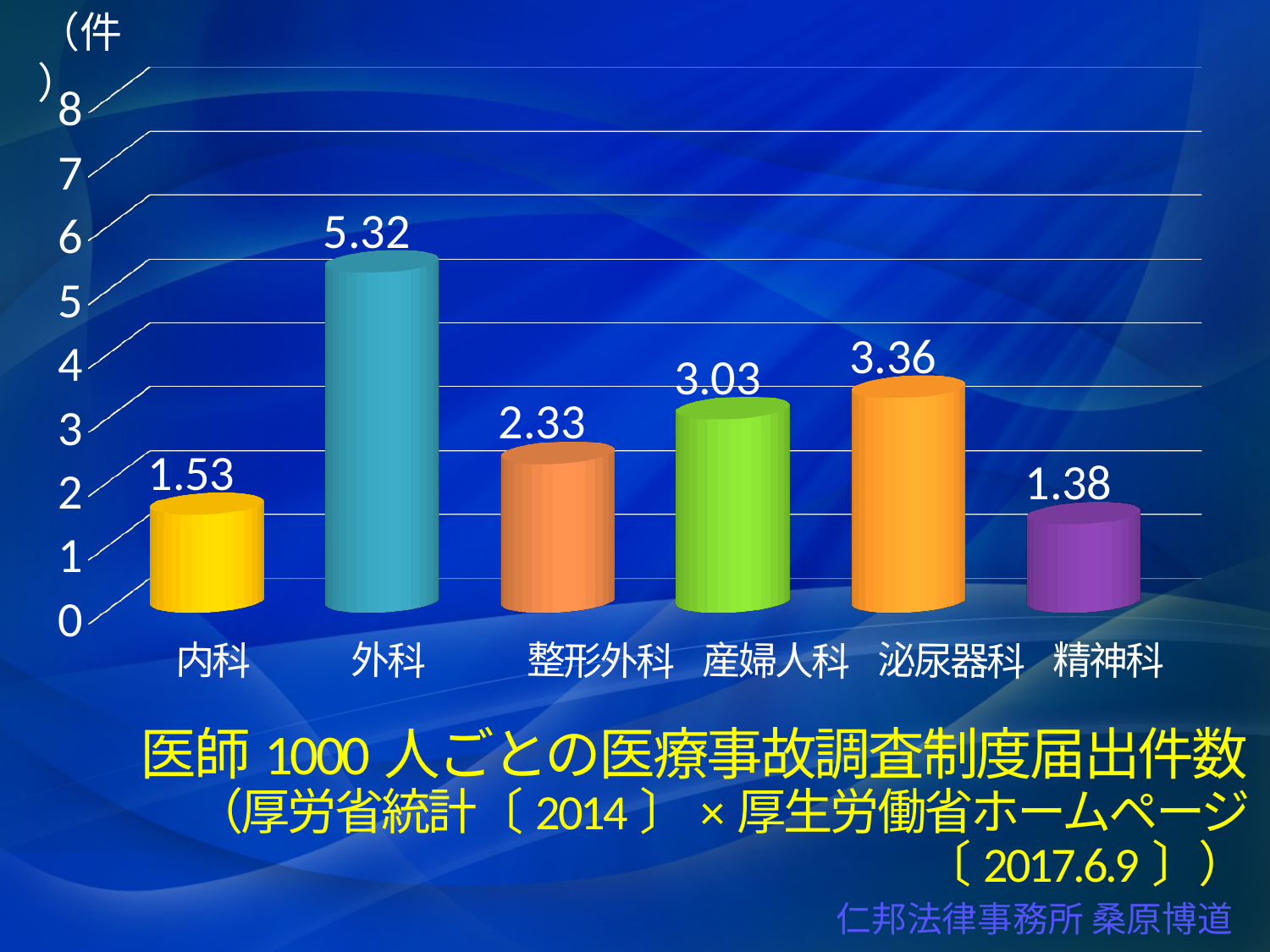
Is the value for 外科 greater or less than 5? greater Which is larger, the value for 整形外科 or the value for 産婦人科? 産婦人科 What is the value for 泌尿器科? 3.36 What is the value for 精神科? 1.38 Which category has the lowest value? 精神科 Which category has the highest value? 外科 What kind of chart is shown on the slide? bar chart What is the value for 外科? 5.32 How many categories are shown on the x axis? 6 What is the difference between the values for 泌尿器科 and 産婦人科? 0.33 What unit is shown at the top of the vertical axis? 件 What is the difference between the values for 外科 and 内科? 3.79